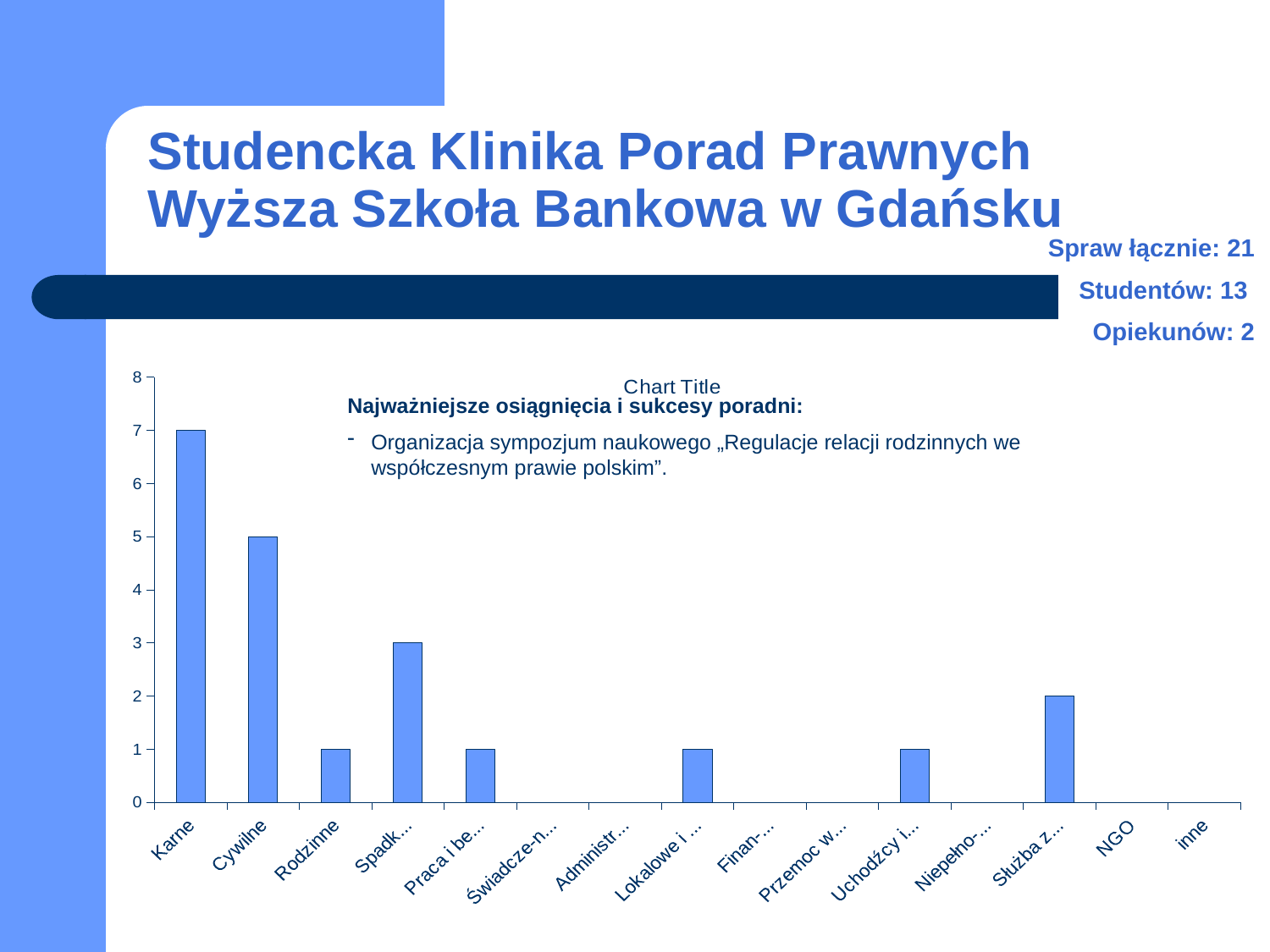
Is the value for Karne greater or less than 6? greater Which category has the highest value? Karne What is the value for Rodzinne? 1 How many categories are shown on the x axis? 15 What is the difference between the values for Karne and Cywilne? 2 What type of chart is shown on the slide? bar chart Which is larger, the value for Cywilne or the value for Rodzinne? Cywilne What is the title shown on the chart? Chart Title What is the value for NGO? 0 What is the value for Karne? 7 Is the value for Cywilne greater or less than 4? greater What is the value for Cywilne? 5